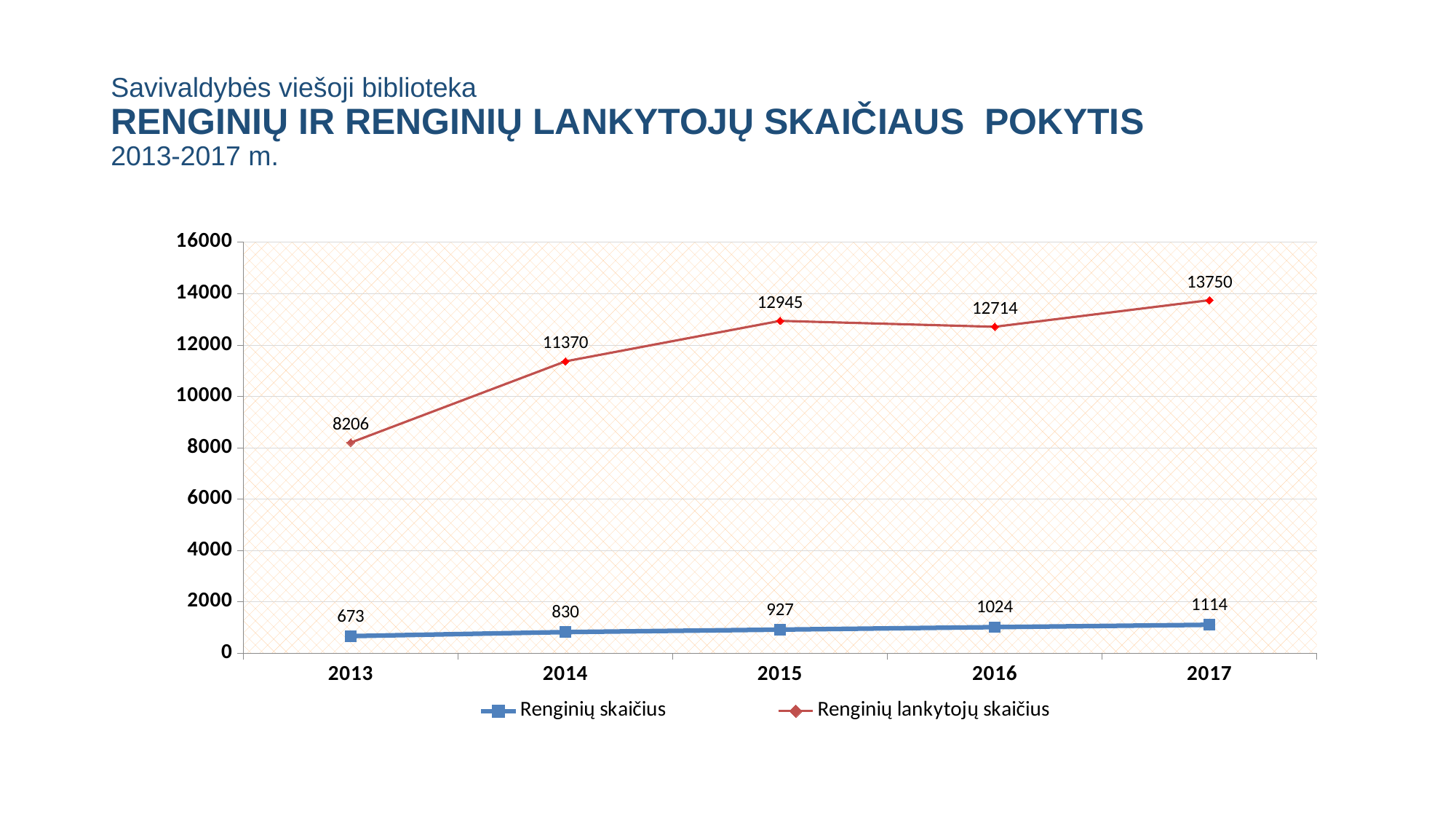
What is the value of Renginių lankytojų skaičius in 2014? 11370 In which year is Renginių lankytojų skaičius highest? 2017 What is the difference between Renginių lankytojų skaičius in 2017 and in 2013? 5544 What is the difference between Renginių skaičius in 2016 and in 2014? 194 Which year has the larger Renginių lankytojų skaičius, 2015 or 2016? 2015 In which year is Renginių skaičius lowest? 2013 How many series does the legend list? 2 Is the value of Renginių lankytojų skaičius in 2013 greater or less than 10000? less What is the value of Renginių skaičius in 2015? 927 What kind of chart is shown on the slide? line chart How many years are shown on the x axis? 5 Does Renginių skaičius rise or fall from 2013 to 2017? rise